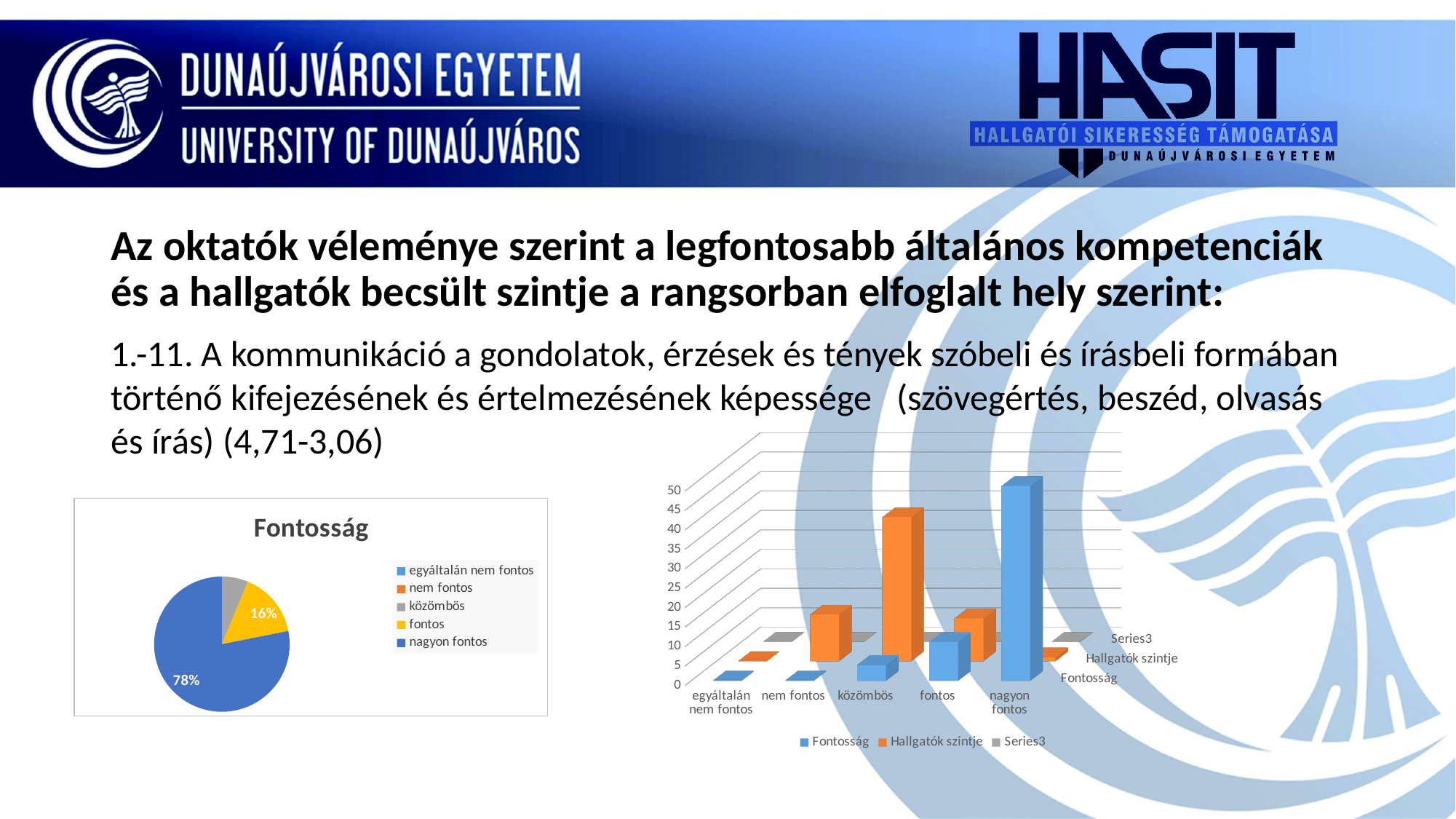
What kind of chart is the chart on the left of the slide? pie chart How many categories are shown on the x axis of the bar chart on the right? 5 What is the title of the chart on the left of the slide? Fontosság In the pie chart titled Fontosság, what share does the 'nagyon fontos' slice have? 78% In the bar chart on the right, which category has the highest value for the Fontosság series? nagyon fontos In the bar chart on the right, is the Hallgatók szintje value for 'közömbös' greater or less than 30? greater What kind of chart is the chart on the right of the slide? bar chart How many series does the legend of the bar chart on the right list? 3 How many entries does the legend of the pie chart titled Fontosság list? 5 In the pie chart titled Fontosság, what share does the 'fontos' slice have? 16% In the pie chart titled Fontosság, which category has the largest slice? nagyon fontos In the bar chart on the right, which category has the highest value for the Hallgatók szintje series? közömbös